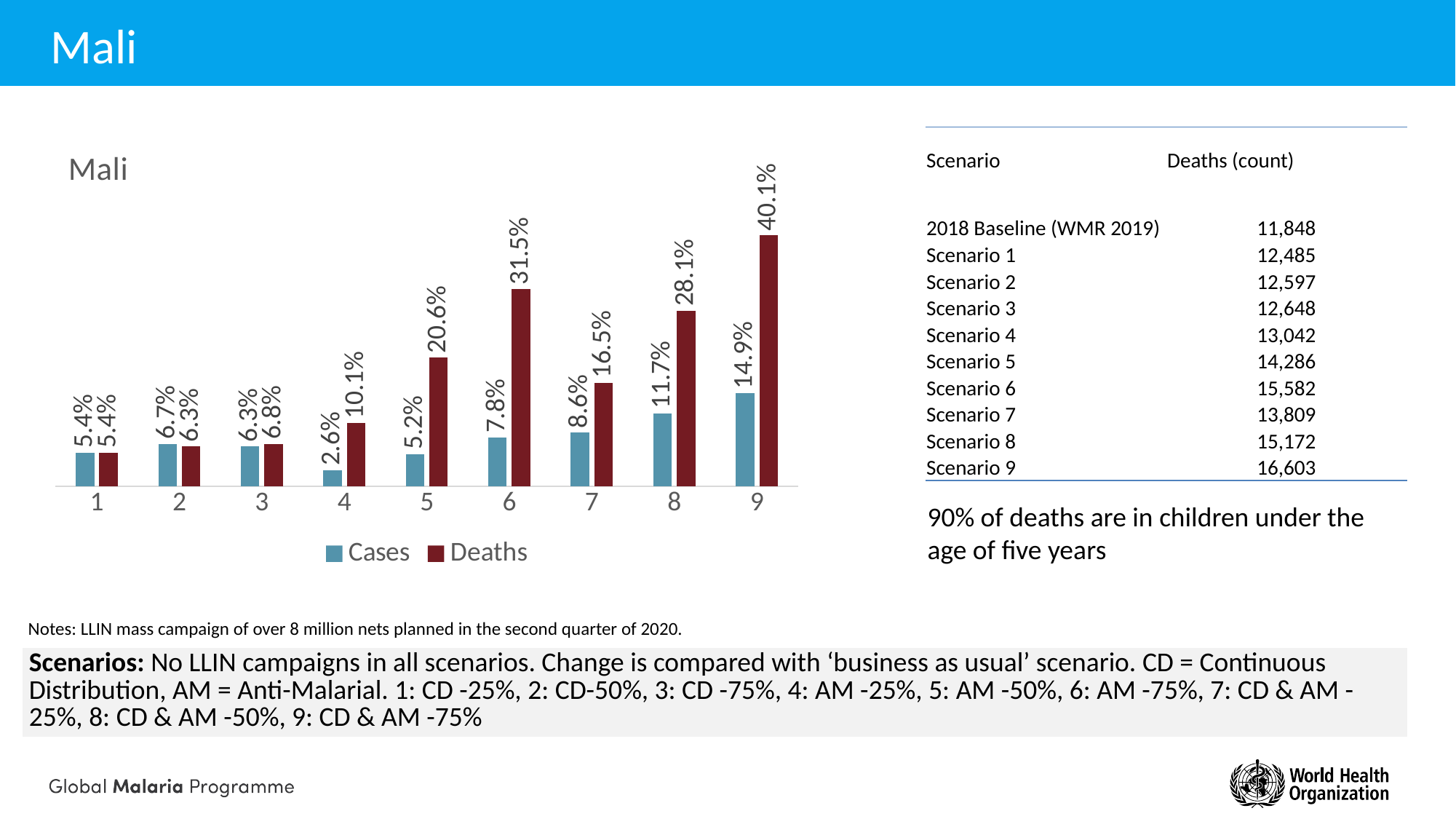
What is the difference between the Deaths values for scenario 9 and scenario 8? 12.0% What are the two series named in the chart legend? Cases and Deaths Which scenario has the highest Deaths value? 9 How many series does the chart legend list? 2 What is the Cases value for scenario 4? 2.6% What kind of chart is shown on the slide? Bar chart Which is larger for scenario 8: the Cases value or the Deaths value? Deaths Which scenario has the lowest Cases value? 4 What is the Deaths value for scenario 9? 40.1% What is the Deaths value for scenario 6? 31.5% How many scenarios are shown on the x axis of the chart? 9 What is the difference between the Deaths and Cases values for scenario 6? 23.7%